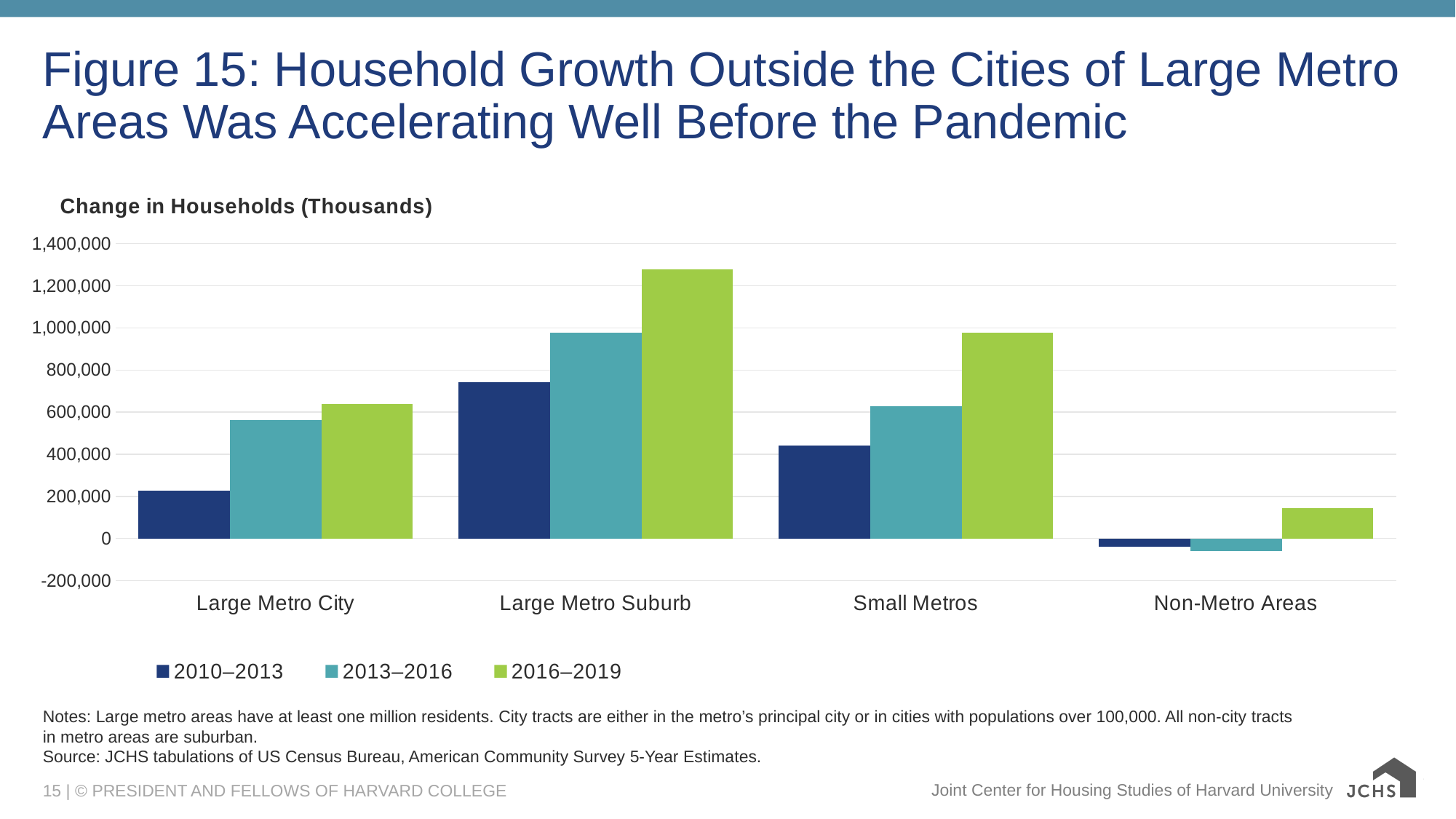
What is the title of the vertical axis? Change in Households (Thousands) Which is larger for 2016–2019: Small Metros or Large Metro City? Small Metros Is the value for Non-Metro Areas in 2013–2016 greater or less than 0? less How many series does the legend list? 3 What kind of chart is shown on the slide? Bar chart How many categories are shown on the x axis? 4 Do the values for Large Metro Suburb rise or fall from 2010–2013 to 2016–2019? rise Which category has the highest value for 2016–2019? Large Metro Suburb Is the value for Large Metro Suburb in 2016–2019 greater or less than 1,200,000? greater Which category has the lowest value for 2016–2019? Non-Metro Areas Is the value for Large Metro City in 2010–2013 greater or less than 400,000? less